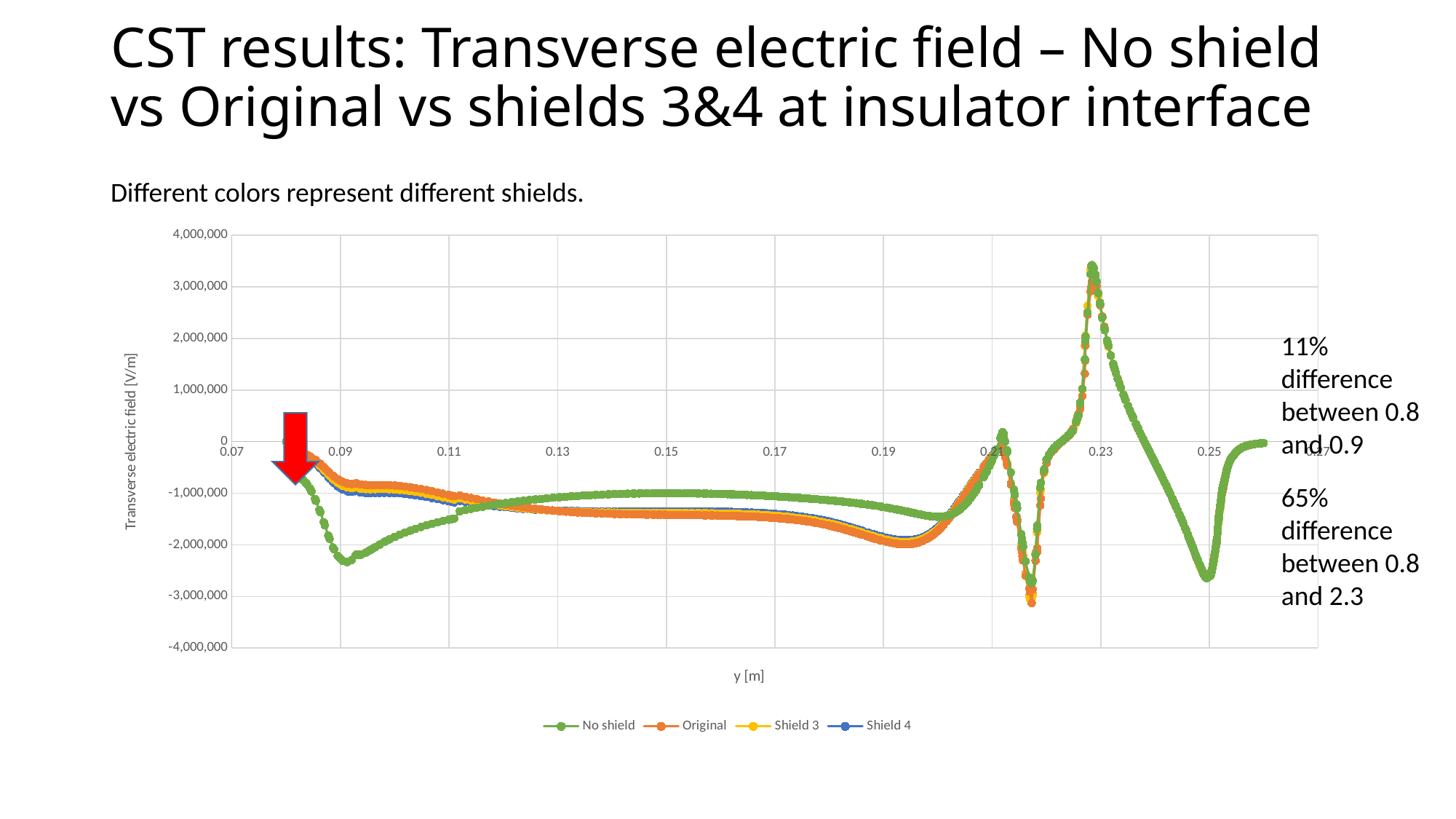
At y = 0.15, is the Original series greater or less than -1,000,000? less Which series reaches the lowest value in the region between y = 0.07 and y = 0.11? No shield Is the lowest value of the No shield series between 0.07 and 0.11 greater or less than -2,000,000? less Is the peak value of the curves near y = 0.23 greater or less than 3,000,000? greater What is the label of the x axis? y [m] What are the series names listed in the legend? No shield, Original, Shield 3, Shield 4 How many series does the legend list? 4 At y = 0.09, which series has the lower value, No shield or Original? No shield At y = 0.15, which series has the higher value, No shield or Original? No shield What kind of chart is shown on the slide? line chart